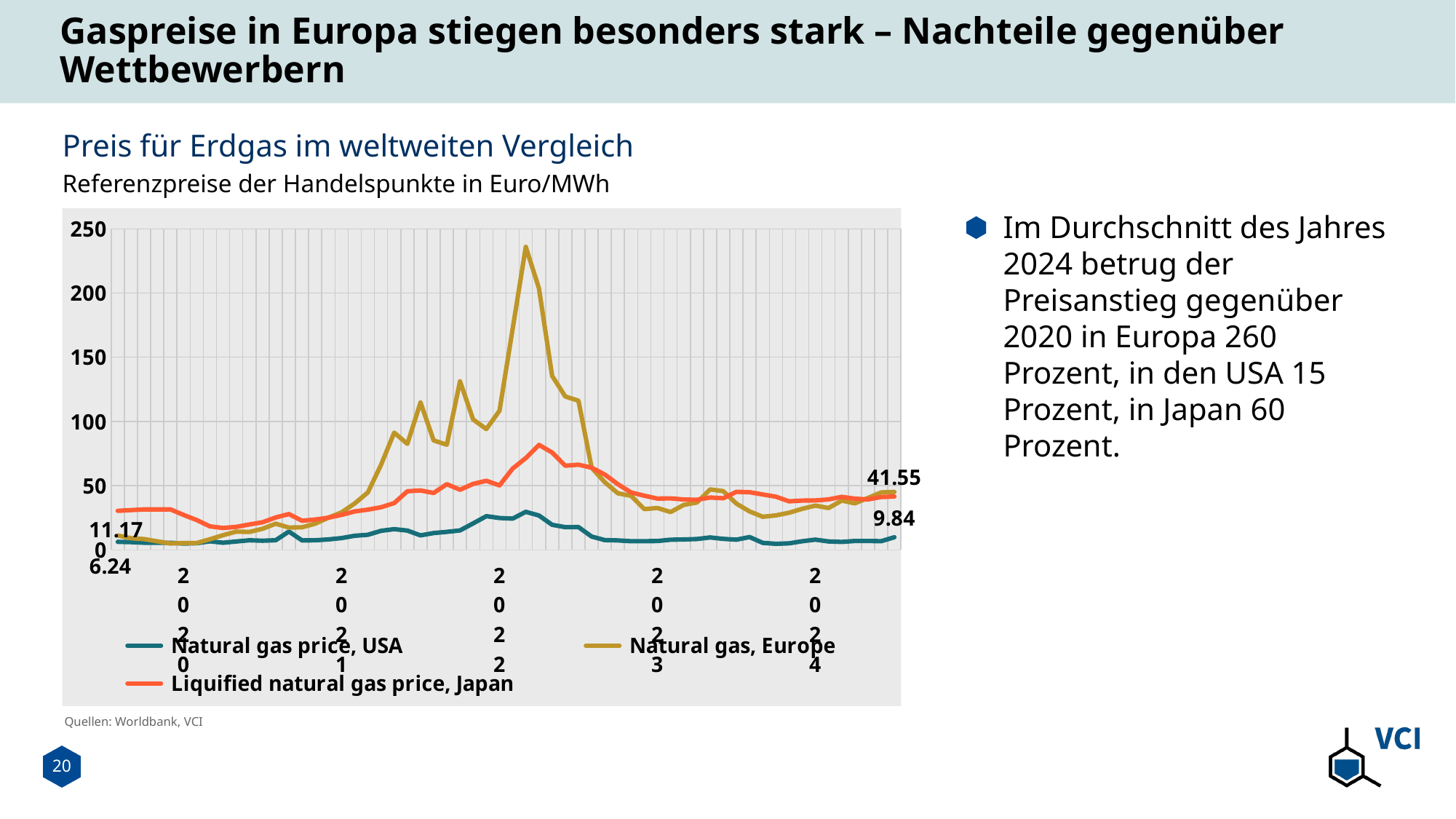
What is the first labelled value of the Natural gas, Europe series at the start of the chart? 11.17 How many series does the chart legend list? 3 Is the peak value of the Liquified natural gas price, Japan series greater or less than 100? less What is the last labelled value of the Natural gas price, USA series at the end of the chart? 9.84 Which series reaches the highest peak in the chart? Natural gas, Europe What is the first labelled value of the Natural gas price, USA series at the start of the chart? 6.24 At the end of the chart, which is larger: the labelled value for Natural gas, Europe or for Natural gas price, USA? Natural gas, Europe What kind of chart is shown on the slide? line chart Is the peak value of the Natural gas, Europe series greater or less than 200? greater In what unit are the prices in the chart given? Euro/MWh